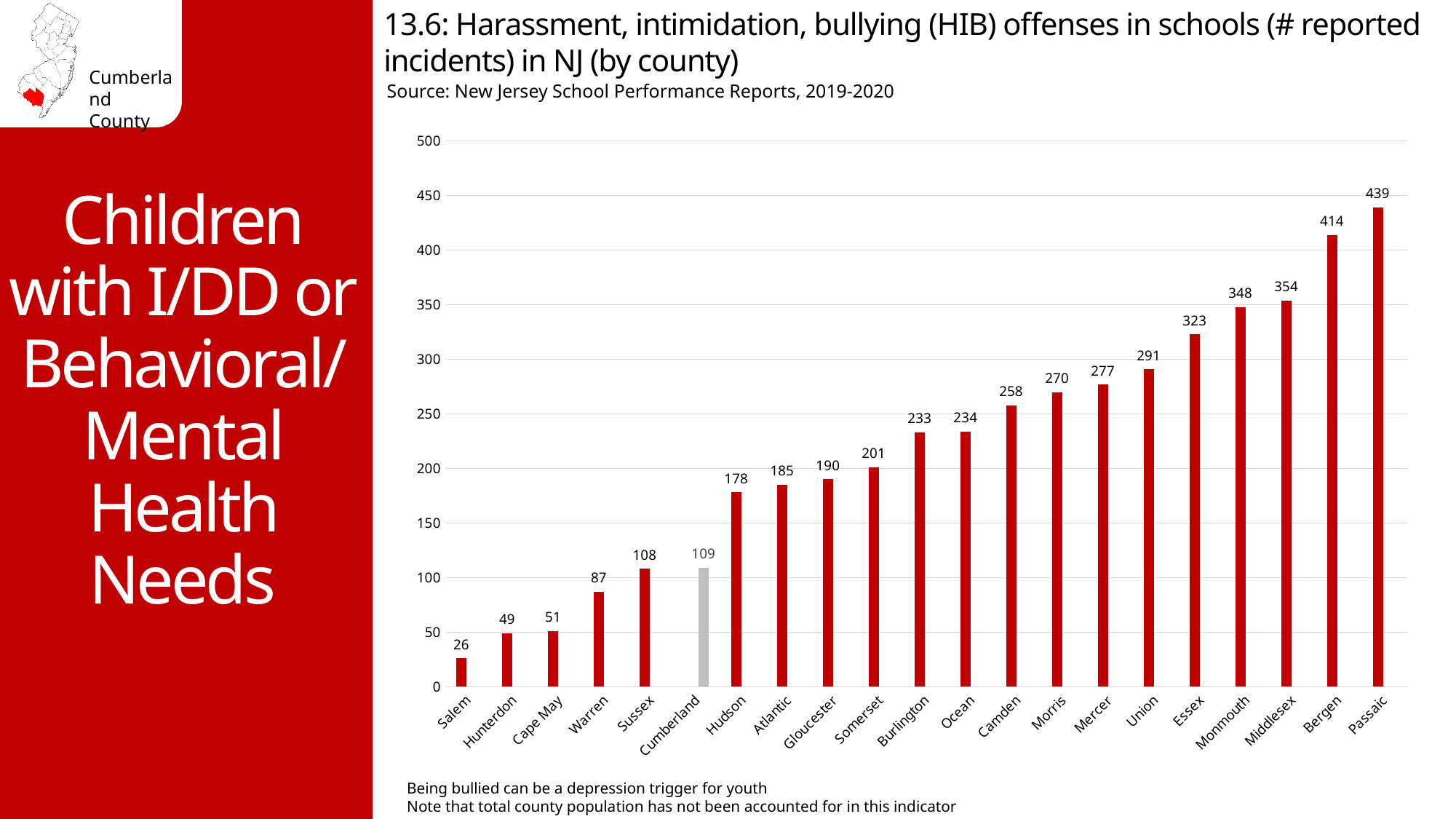
Which county has more reported HIB incidents, Essex or Monmouth? Monmouth What is the difference between the reported HIB incidents in Cumberland and Sussex? 1 Which county has the highest number of reported HIB incidents? Passaic Which county has the lowest number of reported HIB incidents? Salem How many HIB incidents were reported in Cumberland County? 109 Do the values rise or fall moving from left to right along the x axis? Rise What is the number of reported HIB incidents for Bergen? 414 How many counties are shown on the chart? 21 What kind of chart is shown on the slide? Bar chart Is the value for Union greater or less than 300? less Which county's bar is shown in grey rather than red? Cumberland What is the difference between the reported HIB incidents in Passaic and Bergen? 25